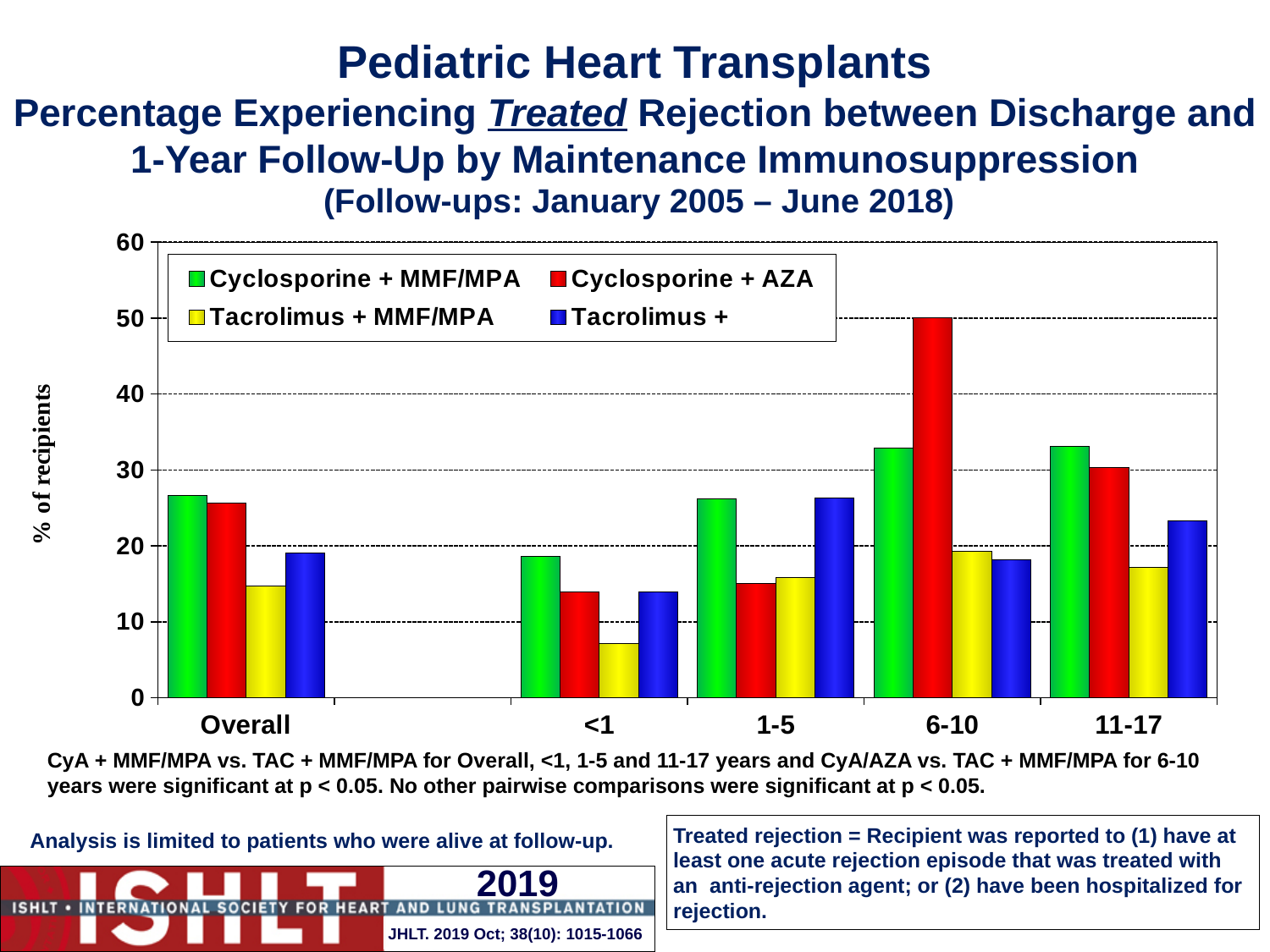
Which series has the highest bar in the 6-10 age group? Cyclosporine + AZA What is the label on the y axis? % of recipients How many age-group categories are shown on the x axis? 4 How many series does the legend list? 4 Is the value for Cyclosporine + AZA in the 6-10 age group greater or less than 40? greater Which series has the lowest bar in the <1 age group? Tacrolimus + MMF/MPA In the 6-10 age group, which is larger: Cyclosporine + AZA or Cyclosporine + MMF/MPA? Cyclosporine + AZA Which series has the lowest bar in the Overall group? Tacrolimus + MMF/MPA What kind of chart is shown on the slide? bar chart Is the value for Cyclosporine + MMF/MPA in the Overall group greater or less than 20? greater Is the value for Tacrolimus + MMF/MPA in the <1 age group greater or less than 10? less